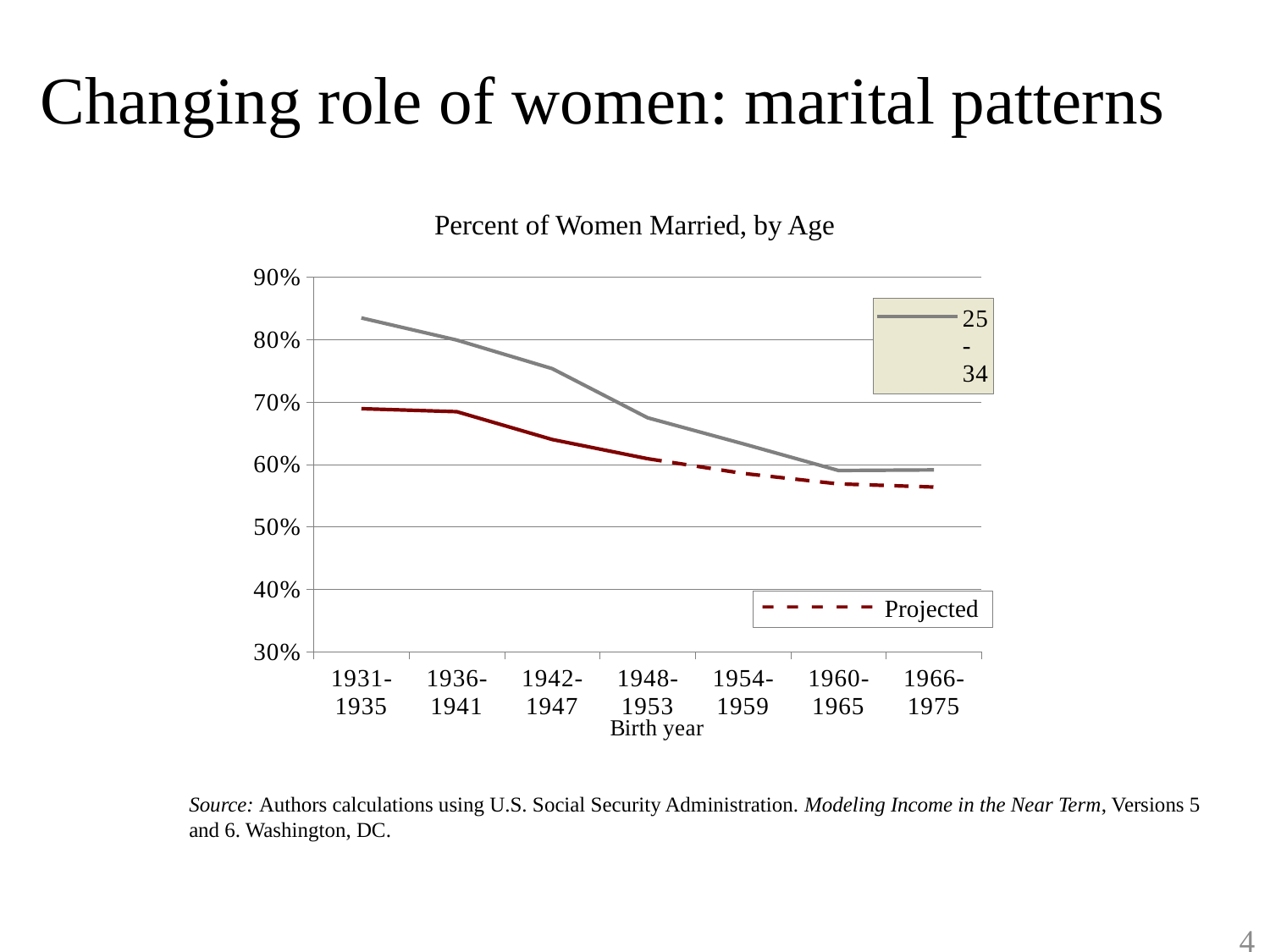
What is the title of the chart? Percent of Women Married, by Age Is the value of the dark red line for the 1931-1935 birth year greater or less than 70%? less Do the values of the 25-34 line rise or fall across the birth years from 1931-1935 to 1960-1965? fall Is the value of the dark red line for the 1966-1975 birth year greater or less than 60%? less Is the value of the 25-34 line for the 1948-1953 birth year greater or less than 70%? less What kind of chart is shown on the slide? line chart How many birth-year groups are shown on the x axis? 7 What does the dashed portion of the lines represent, according to the legend? Projected For the 1931-1935 birth year, which line is higher: the 25-34 line or the dark red line? the 25-34 line